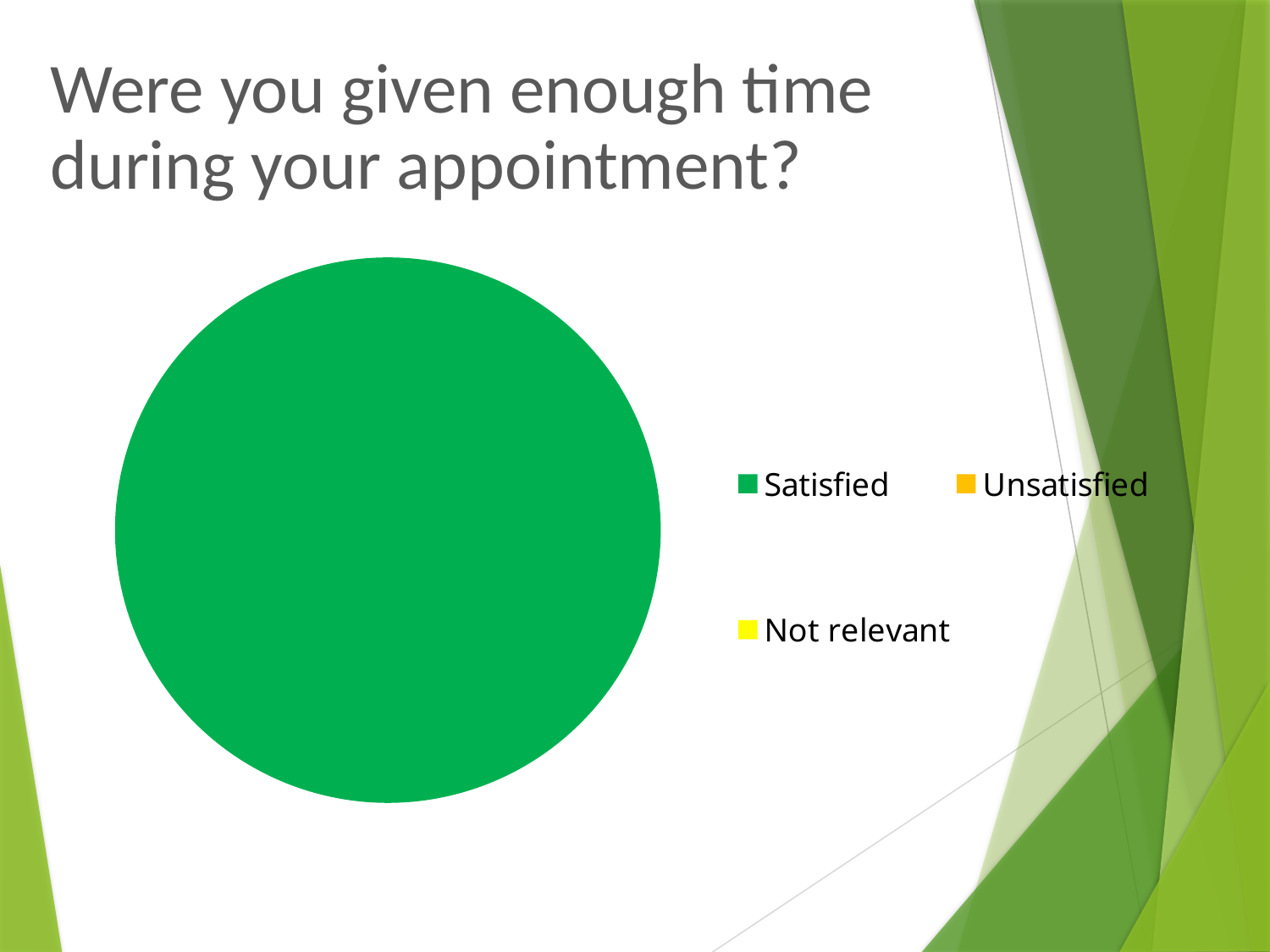
What kind of chart is shown on the slide? pie chart How many categories does the legend list? 3 Which is larger, the share for Satisfied or the share for Not relevant? Satisfied Which category does the entire visible pie represent? Satisfied What is the title of the chart on the slide? Were you given enough time during your appointment? Which is larger, the share for Satisfied or the share for Unsatisfied? Satisfied What colour represents Satisfied in the legend? green How many slices are visible in the pie? 1 Which category has the largest share of the pie? Satisfied